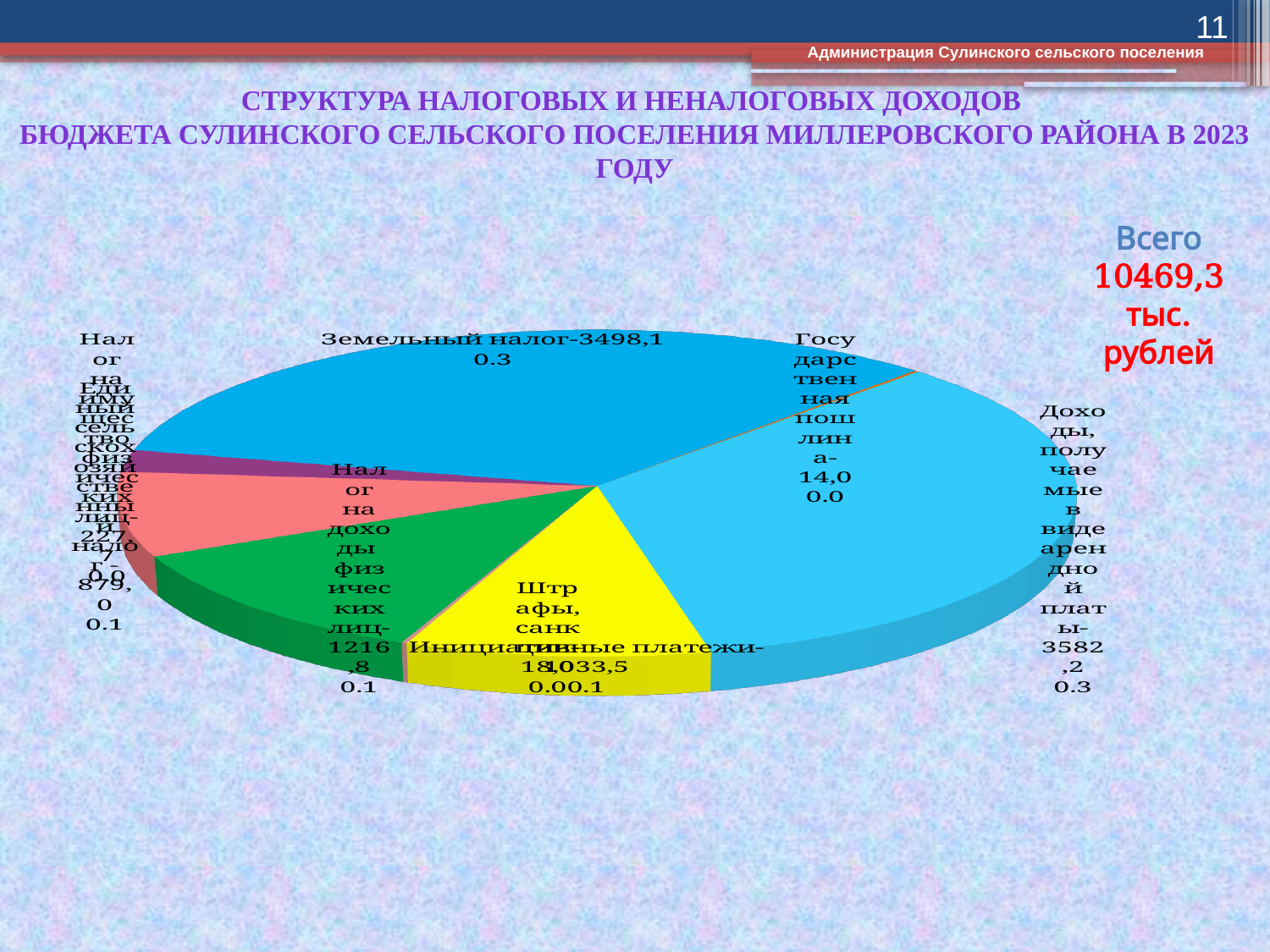
What is the value shown for Доходы, получаемые в виде арендной платы (rental income)? 3582,2 What is the value shown for Инициативные платежи (initiative payments)? 1033,5 What is the value shown for Земельный налог (land tax)? 3498,1 Which category has the smallest value in the pie chart? Государственная пошлина Which is larger: Земельный налог or Налог на доходы физических лиц? Земельный налог Which category has the largest value in the pie chart? Доходы, получаемые в виде арендной платы What total amount (Всего) is stated on the slide for the revenues shown in the chart? 10469,3 тыс. рублей What is the value shown for Государственная пошлина (state duty)? 14,0 What is the difference between Земельный налог (3498,1) and Налог на доходы физических лиц (1216,8)? 2281,3 What share of the pie is labelled for Земельный налог? 0.3 What is the value shown for Налог на доходы физических лиц (personal income tax)? 1216,8 What kind of chart is shown on the slide? pie chart